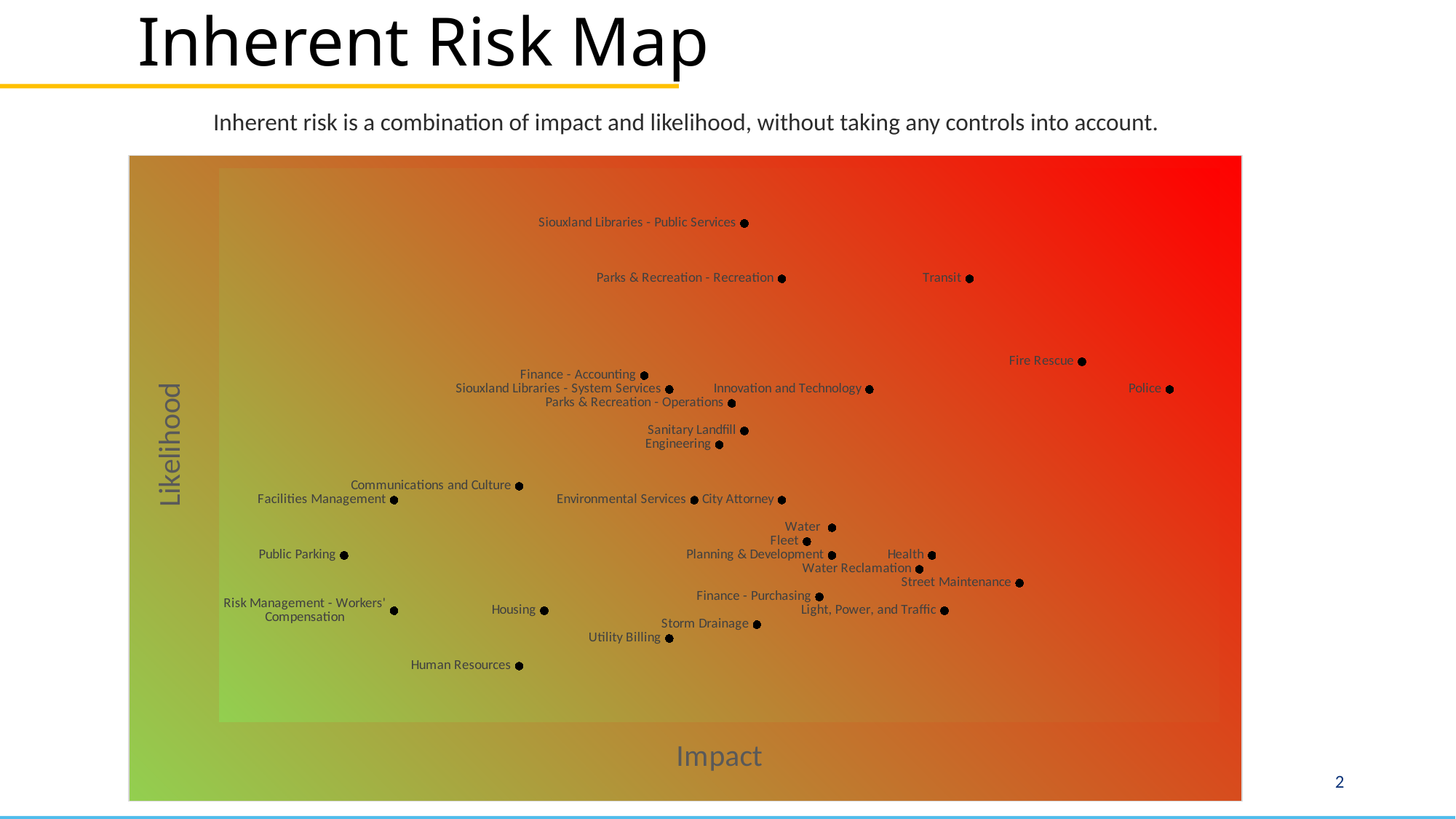
What is the title of the chart on the slide? Inherent Risk Map What kind of chart is shown on the slide? Scatter chart Which point is plotted furthest to the left on the Impact axis? Public Parking Which has the higher likelihood, Housing or Human Resources? Housing Which has the higher likelihood, Transit or Fire Rescue? Transit Which has the higher impact, Street Maintenance or Health? Street Maintenance Which point is plotted lowest on the Likelihood axis? Human Resources Which point is plotted highest on the Likelihood axis? Siouxland Libraries - Public Services How many labelled points are plotted on the chart? 29 Which point is plotted furthest to the right on the Impact axis? Police What is the label of the vertical axis of the chart? Likelihood